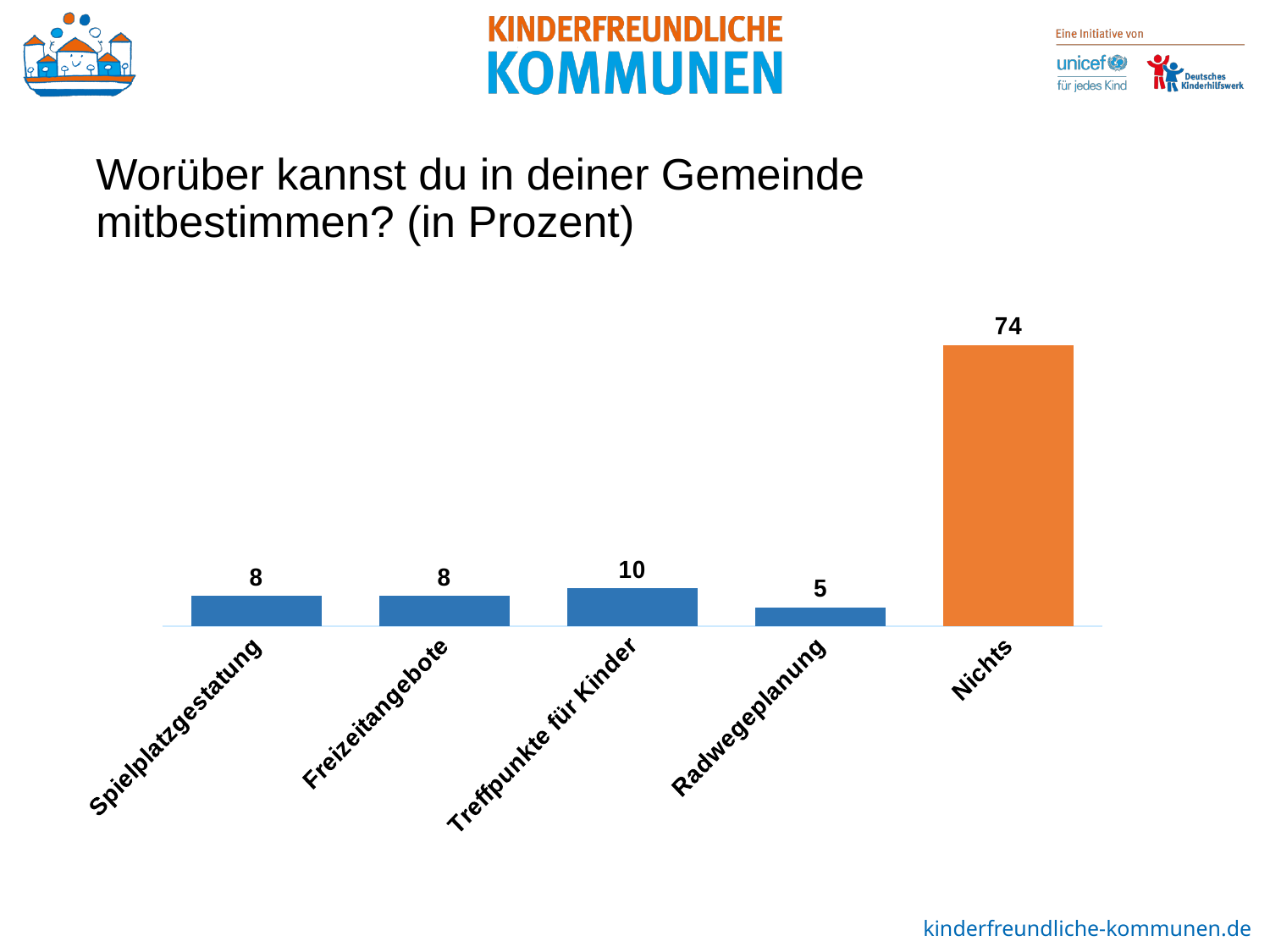
Which is larger, the value for Treffpunkte für Kinder or the value for Radwegeplanung? Treffpunkte für Kinder What kind of chart is shown on the slide? Bar chart What is the value for Radwegeplanung? 5 What is the difference between the values for Freizeitangebote and Radwegeplanung? 3 What is the value for Spielplatzgestaltung? 8 What is the difference between the values for Nichts and Treffpunkte für Kinder? 64 Which category has the lowest value? Radwegeplanung What is the value for Treffpunkte für Kinder? 10 Which bar is coloured orange rather than blue? Nichts Which category has the highest value? Nichts What is the value for Nichts? 74 How many categories are shown in the chart? 5